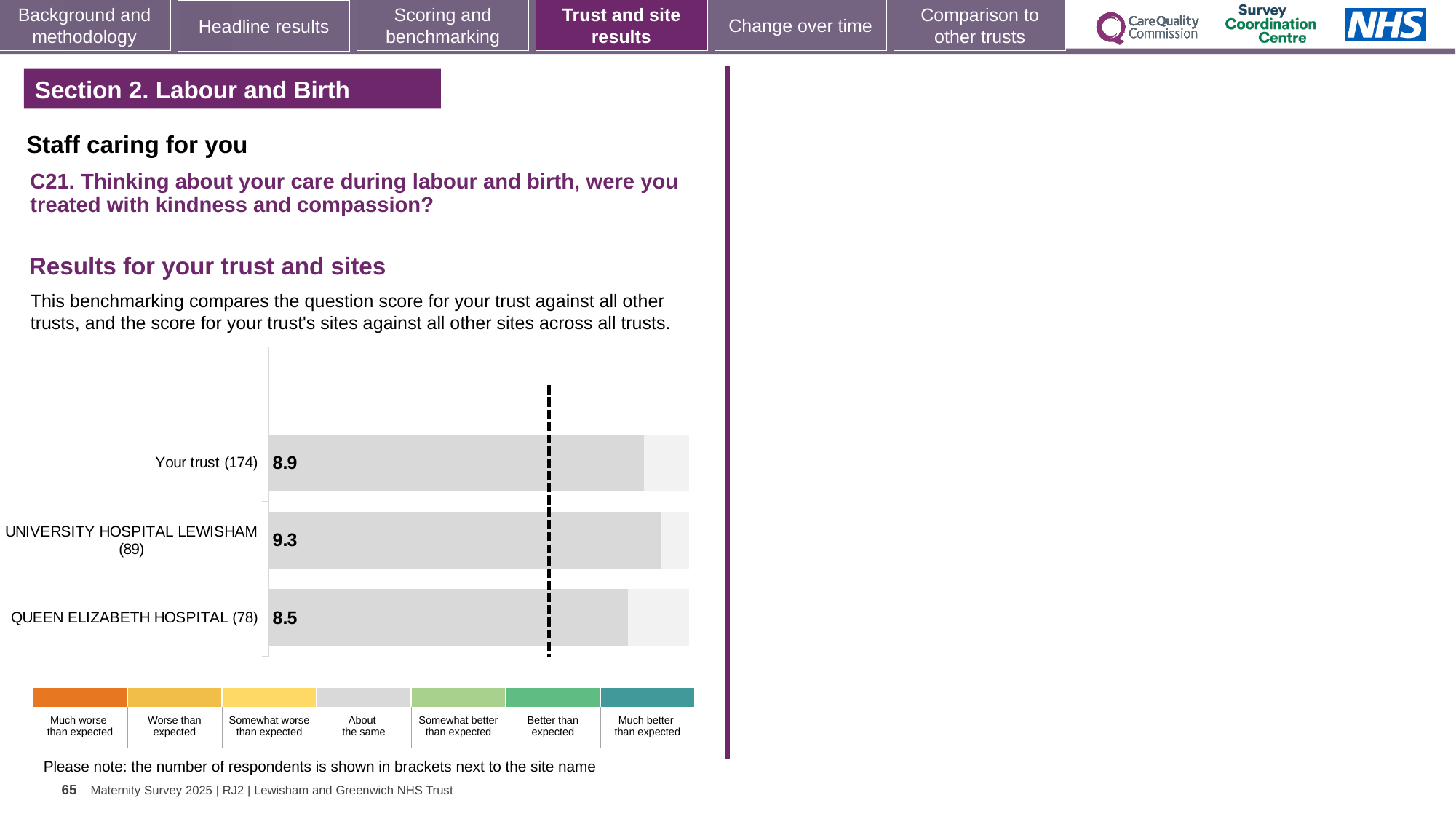
How many rating categories does the colour legend below the chart list? 7 What is the score for University Hospital Lewisham? 9.3 What is the difference between the scores for University Hospital Lewisham and Queen Elizabeth Hospital? 0.8 What kind of chart is shown? Bar chart Which site or trust has the highest score? University Hospital Lewisham How many respondents are shown in brackets for Queen Elizabeth Hospital? 78 Which site or trust has the lowest score? Queen Elizabeth Hospital How many bars are plotted in the chart? 3 What is the score for Queen Elizabeth Hospital? 8.5 What is the score for Your trust? 8.9 Which has a higher score, Your trust or University Hospital Lewisham? University Hospital Lewisham What is the difference between the scores for Your trust and Queen Elizabeth Hospital? 0.4